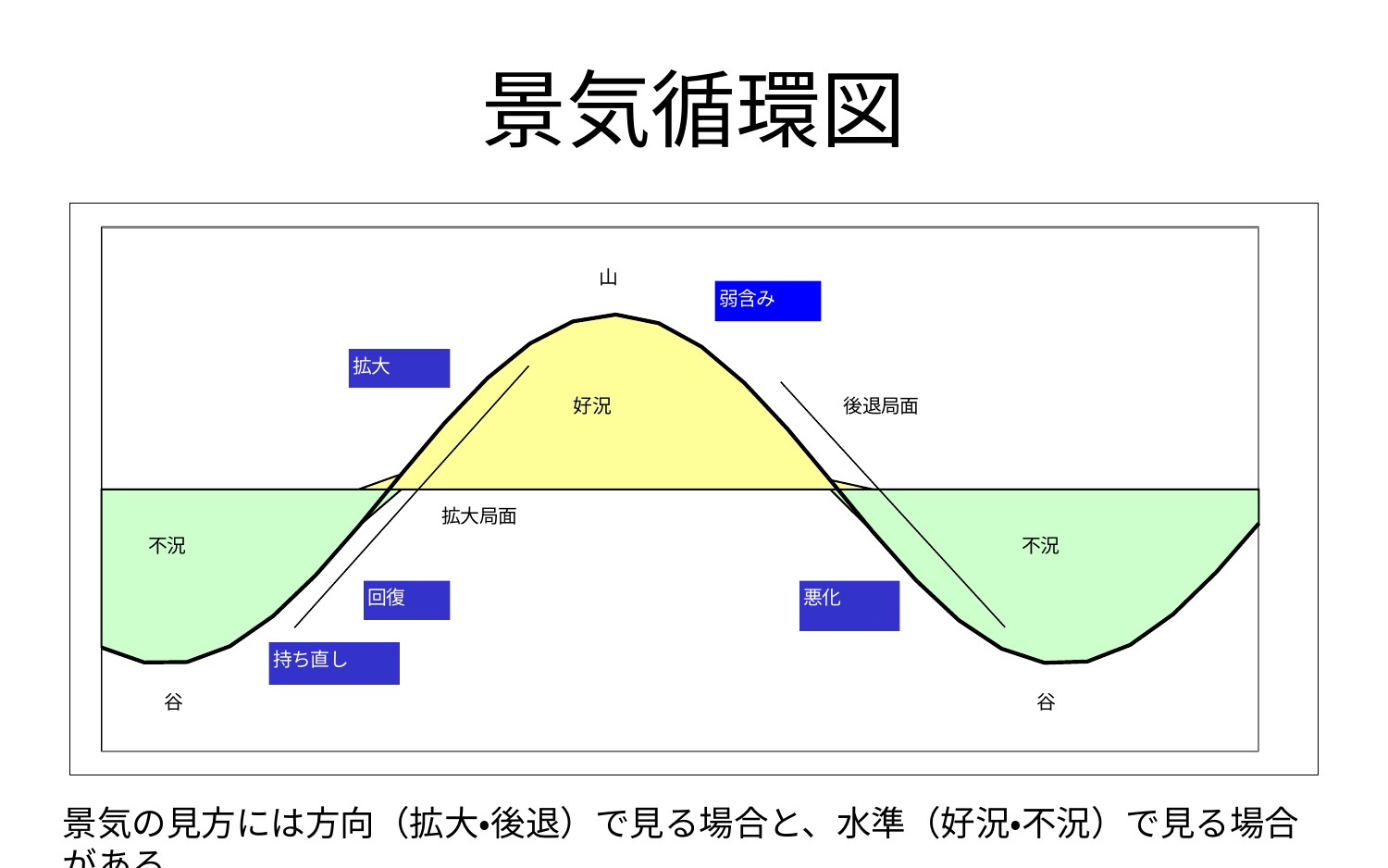
Does the curve rise or fall between the 山 and the right 谷? fall What is the title of the chart on the slide? 景気循環図 How many troughs labeled 谷 are shown in the chart? 2 How many regions labeled 好況 are shown in the chart? 1 What label appears at the peak of the curve in the chart? 山 How many regions labeled 不況 are shown in the chart? 2 Does the curve rise or fall between the left 谷 and the 山? rise